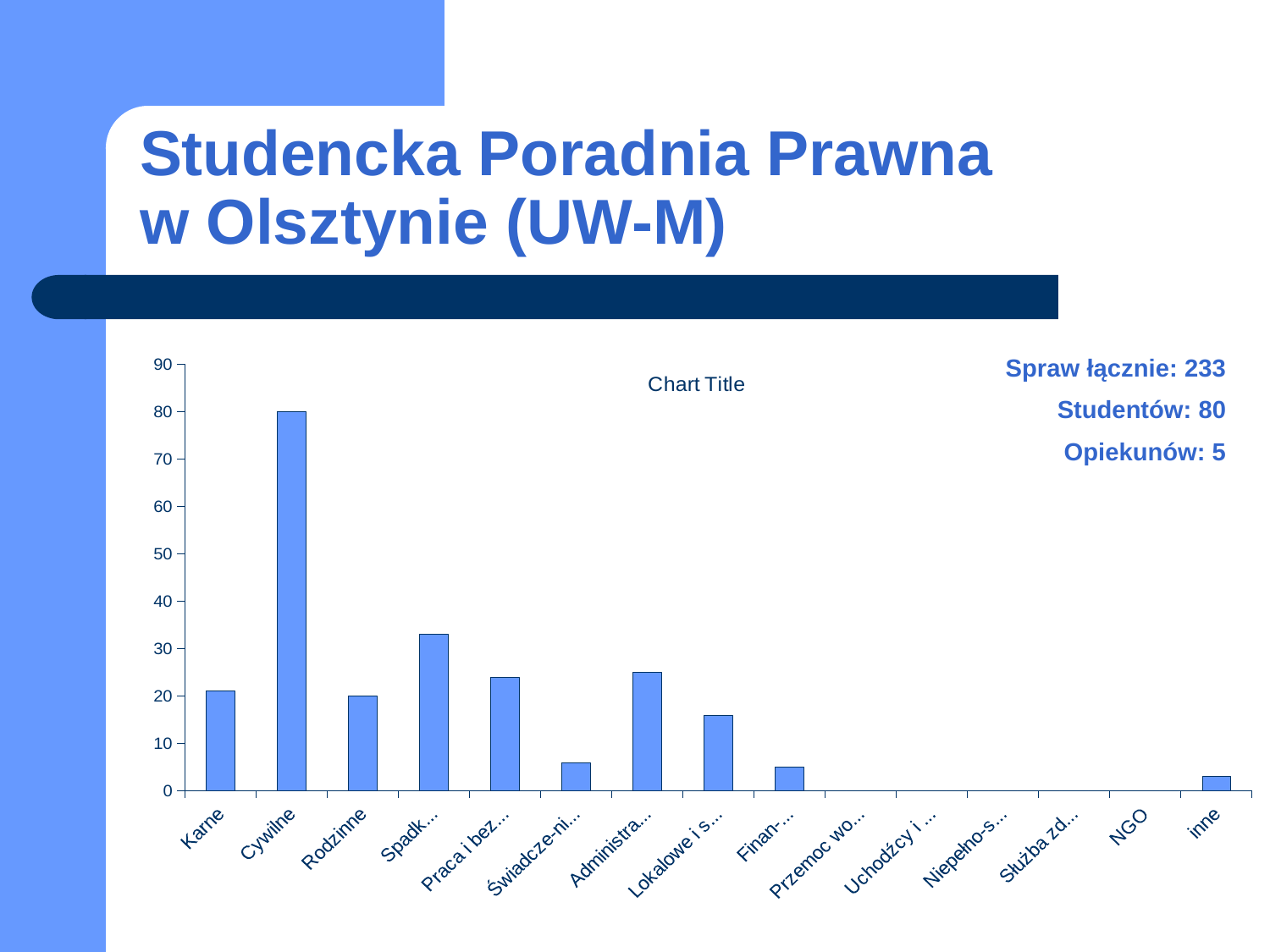
What is the value for Cywilne? 80 Is the value for Karne greater or less than 30? less Is the value for Świadcze-ni... greater or less than 10? less What kind of chart is shown on the slide? bar chart Which is larger, the value for Administra... or the value for Lokalowe i s...? Administra... Which category has the highest bar in the chart? Cywilne Which is larger, the value for Spadk... or the value for Praca i bez...? Spadk... What is the title shown on the chart? Chart Title How many categories are shown on the x axis of the chart? 15 Is the value for Spadk... greater or less than 30? greater What is the value for Rodzinne? 20